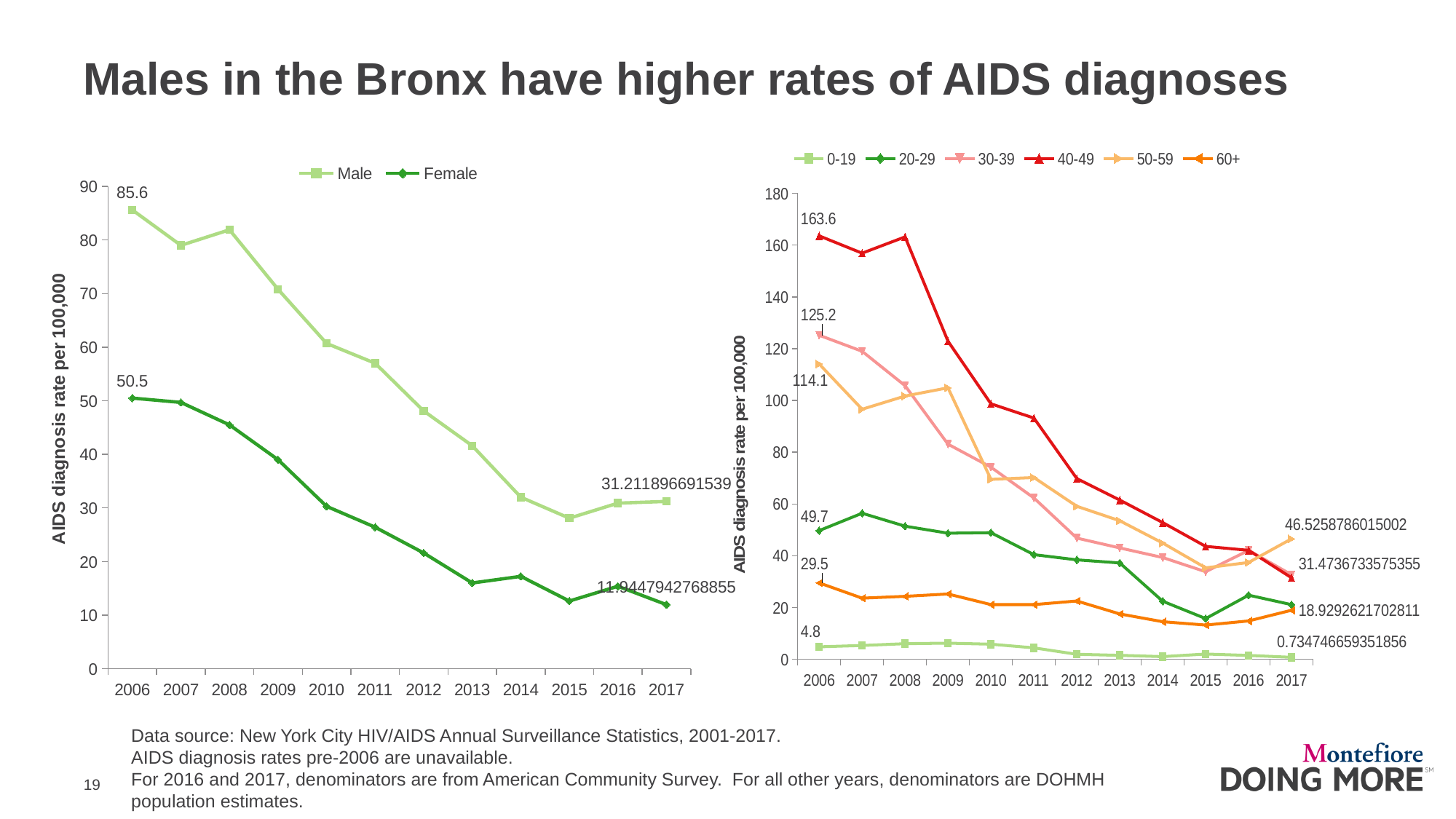
In the left chart (Male vs Female), how many series does the legend list? 2 In the right chart (age groups), how many series does the legend list? 6 What kind of chart is the left chart (Male vs Female)? line chart In the left chart (Male vs Female), what was the female AIDS diagnosis rate in 2006? 50.5 In the right chart (age groups), which age group had the lowest rate in 2006? 0-19 In the right chart (age groups), what was the rate for the 50-59 age group in 2017? 46.5258786015002 In the left chart (Male vs Female), what was the male AIDS diagnosis rate in 2006? 85.6 In the right chart (age groups), what was the rate for the 40-49 age group in 2006? 163.6 In the right chart (age groups), is the rate for the 40-49 age group in 2010 greater or less than 80? greater In the left chart (Male vs Female), what is the difference between the male and female rates in 2006? 35.1 In the left chart (Male vs Female), is the male rate in 2014 greater or less than 40? less In the left chart (Male vs Female), does the male rate generally rise or fall from 2006 to 2017? fall